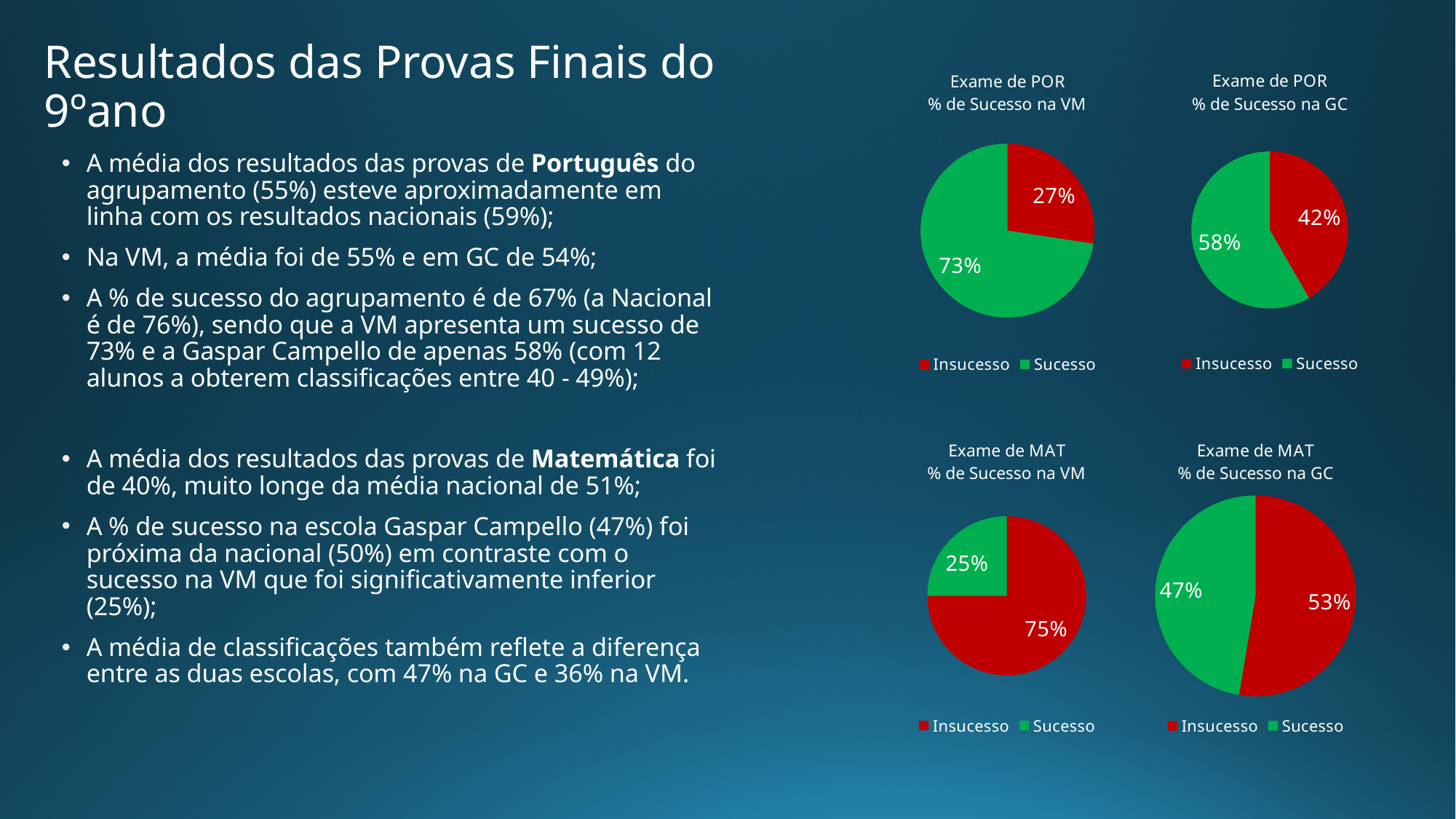
In the chart titled "Exame de MAT % de Sucesso na GC", what colour is the Insucesso slice? Red In the chart titled "Exame de POR % de Sucesso na VM", what is the value for Insucesso? 27% How many entries does the legend of the chart titled "Exame de POR % de Sucesso na VM" list? 2 In the chart titled "Exame de MAT % de Sucesso na VM", which slice is the largest? Insucesso In the chart titled "Exame de MAT % de Sucesso na GC", what is the difference between the Insucesso and Sucesso values? 6% In the chart titled "Exame de POR % de Sucesso na GC", what is the value for Sucesso? 58% What kind of chart is "Exame de MAT % de Sucesso na VM"? Pie chart In the chart titled "Exame de MAT % de Sucesso na VM", what is the value for Insucesso? 75% In the chart titled "Exame de POR % de Sucesso na VM", what is the value for Sucesso? 73% In the chart titled "Exame de POR % de Sucesso na GC", which slice is larger, Insucesso or Sucesso? Sucesso In the chart titled "Exame de MAT % de Sucesso na GC", what is the value for Sucesso? 47% In the chart titled "Exame de POR % de Sucesso na VM", what is the difference between the Sucesso and Insucesso values? 46%